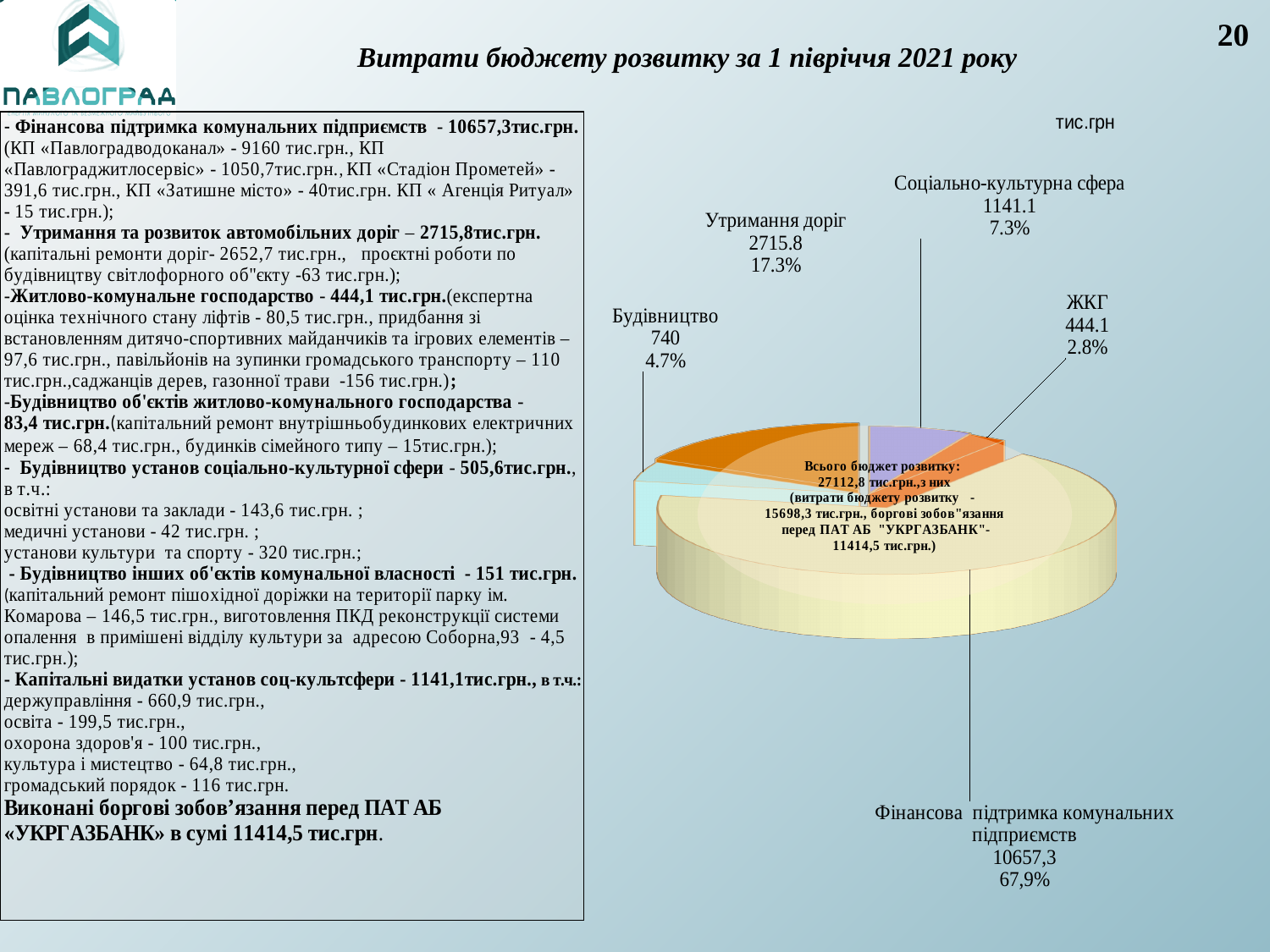
What is the value for Утримання доріг in the pie chart? 2715.8 What kind of chart is shown on the slide? pie chart Which category has the smallest slice in the pie chart? ЖКГ What share of the pie does Фінансова підтримка комунальних підприємств represent? 67,9% What share of the pie does Утримання доріг represent? 17.3% What is the difference between the values for Утримання доріг and Соціально-культурна сфера? 1574.7 What is the value for ЖКГ in the pie chart? 444.1 Which category has the largest slice in the pie chart? Фінансова підтримка комунальних підприємств Which is larger, the value for Будівництво or the value for ЖКГ? Будівництво What is the value for Будівництво in the pie chart? 740 What is the value for Соціально-культурна сфера in the pie chart? 1141.1 How many slices does the pie chart have? 5